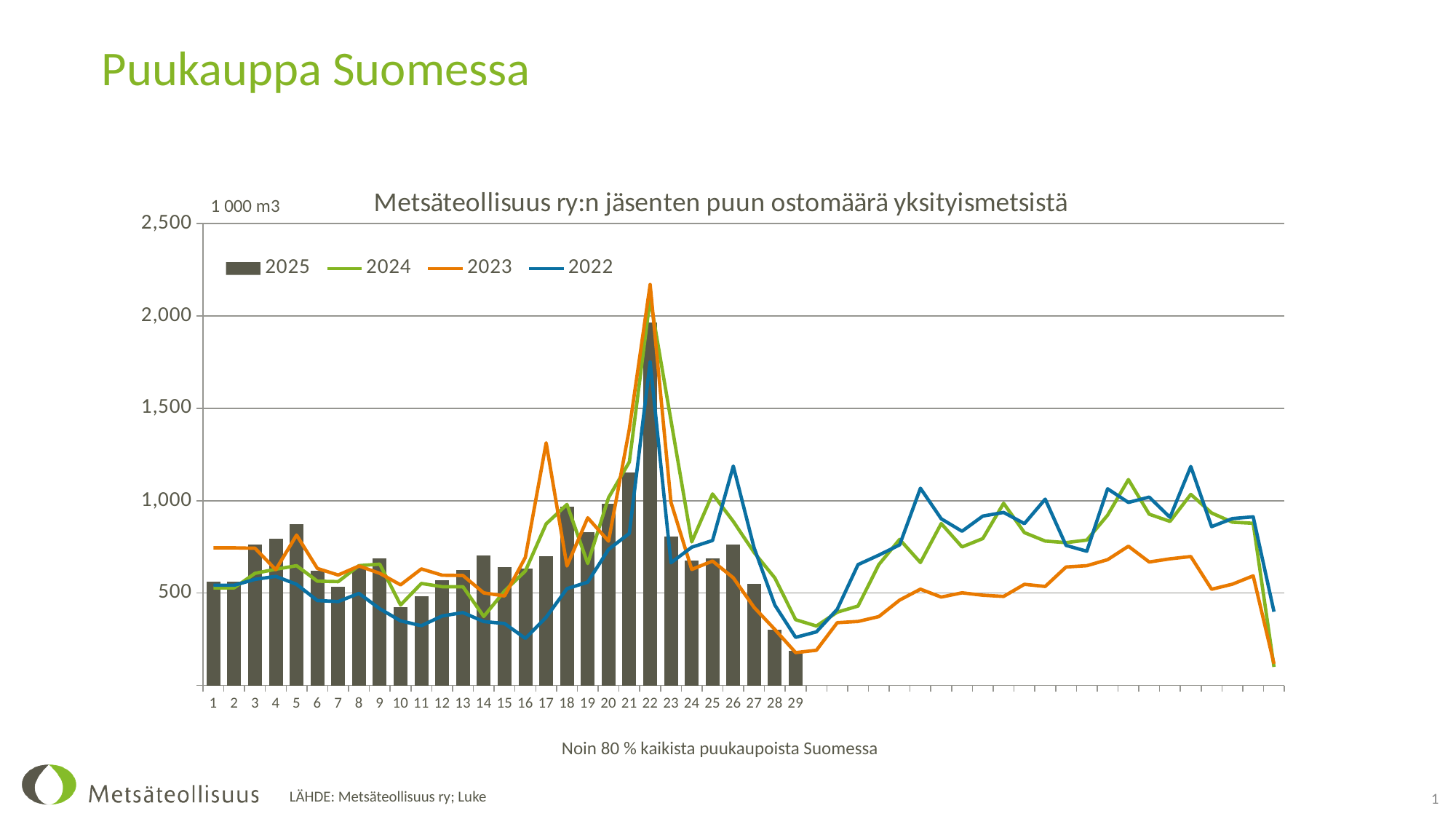
Is the 2023 value for week 17 greater or less than 1,000? greater Which series is drawn as bars rather than a line? 2025 In which week is the 2025 bar lowest? 29 Do the 2025 bars rise or fall from week 22 to week 29? Fall Is the 2025 value for week 22 greater or less than 1,500? greater Is the 2025 value for week 29 greater or less than 500? less How many weeks are shown as bars for the 2025 series? 29 Which is larger for 2025: the bar for week 5 or the bar for week 7? Week 5 In which week is the 2025 bar highest? 22 How many series does the legend list? 4 What kind of chart is shown on the slide? A combined bar and line chart